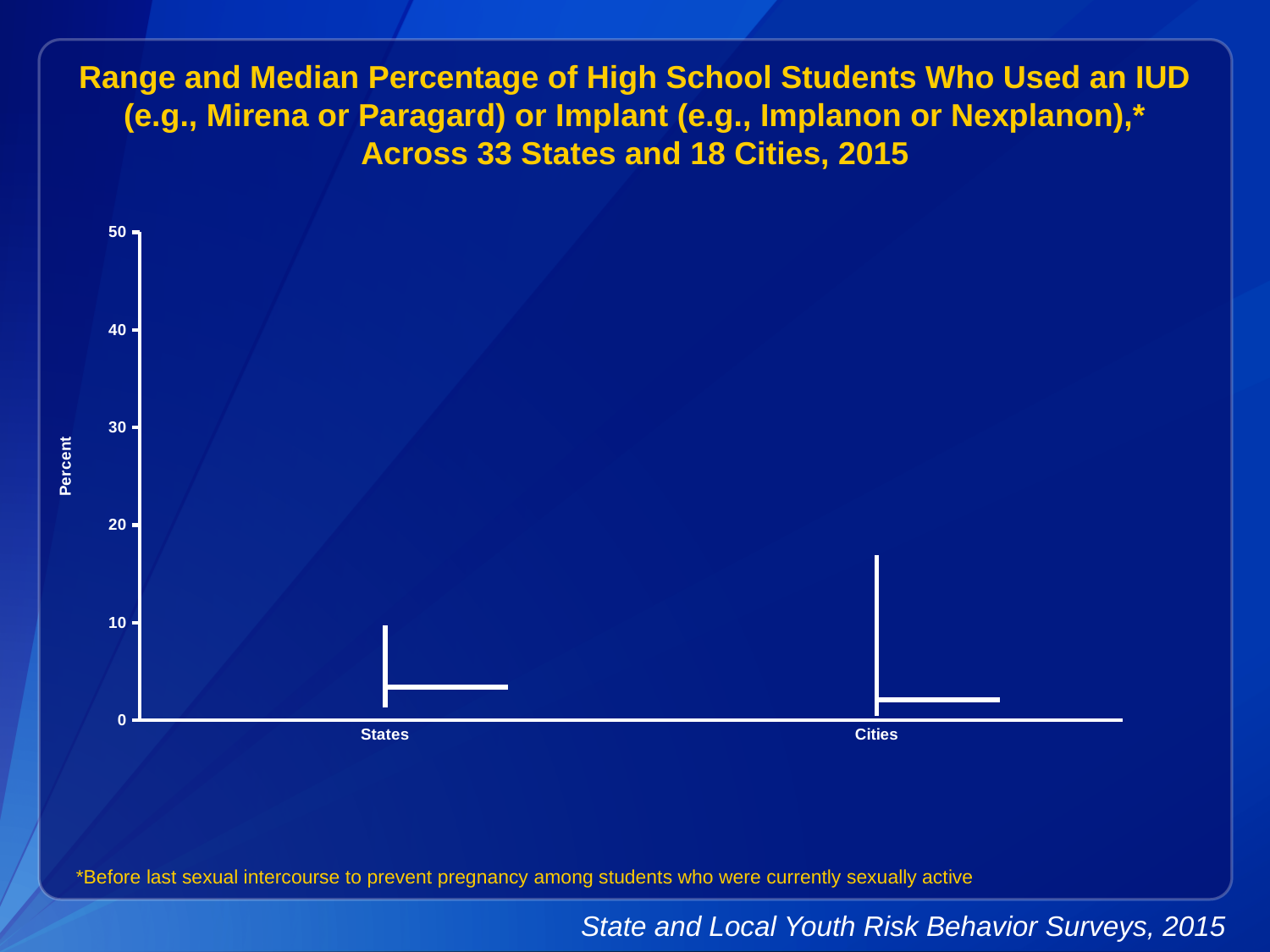
How many categories are shown on the x axis of the chart? 2 Is the median for States greater or less than 10? less Is the upper end of the range for States greater or less than 20? less Which category has the higher median, States or Cities? States Which category has the higher upper end of its range, States or Cities? Cities What is the highest value shown on the y axis of the chart? 50 Is the upper end of the range for Cities greater or less than 10? greater What is the label on the y axis of the chart? Percent What are the two categories shown on the x axis of the chart? States and Cities Which category has the wider range, States or Cities? Cities